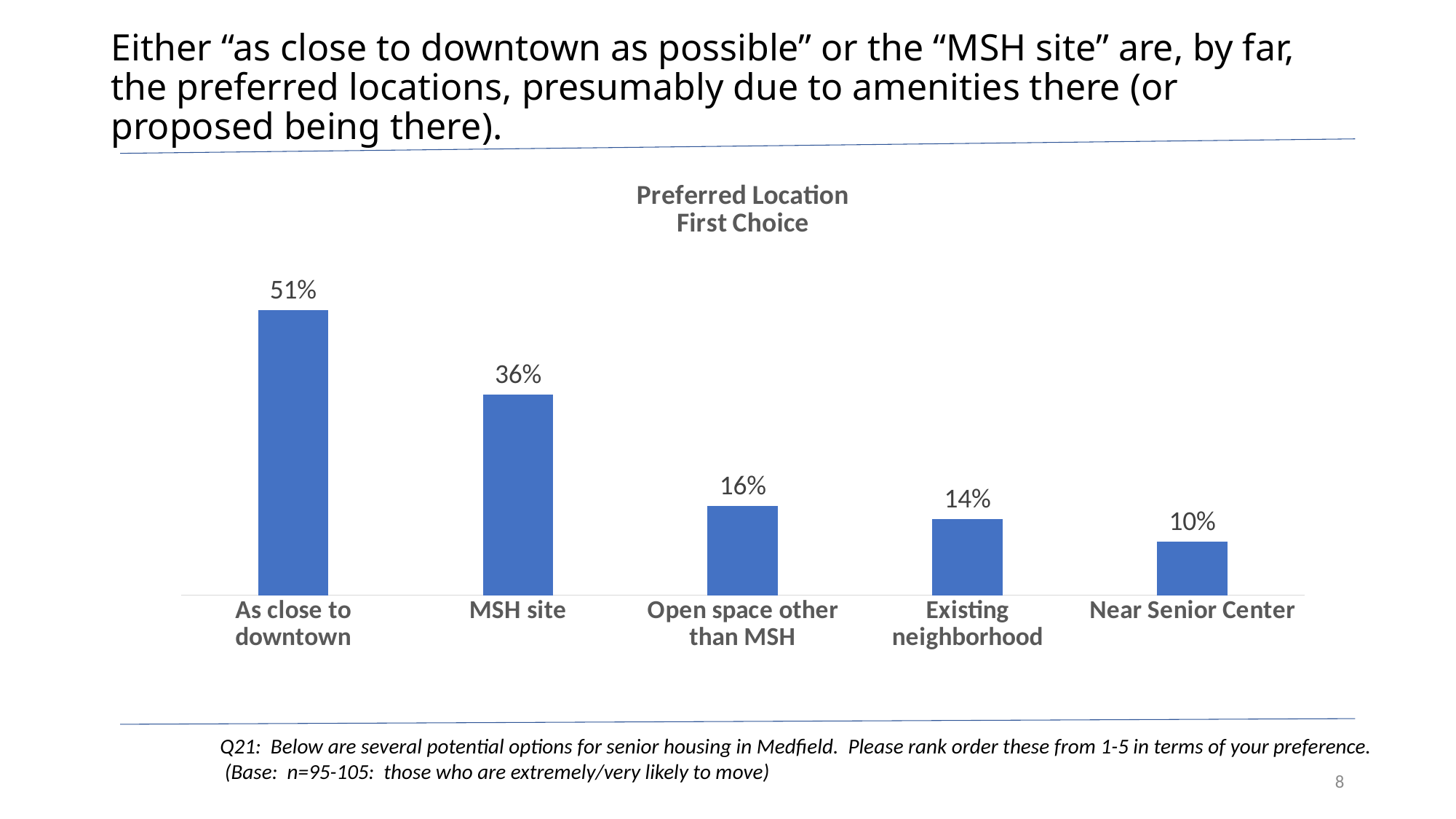
What percentage is shown for "Open space other than MSH"? 16% What is the title of the chart? Preferred Location First Choice What is the value shown for "MSH site"? 36% What is the value for "Near Senior Center"? 10% What percentage chose "As close to downtown" as their first choice preferred location? 51% Which location has the highest first-choice percentage? As close to downtown What is the difference in percentage points between "As close to downtown" and "MSH site"? 15 percentage points Which location has the lowest first-choice percentage? Near Senior Center What type of chart is shown on the slide? Bar chart How many location categories are shown in the chart? 5 What is the difference between "Existing neighborhood" and "Near Senior Center"? 4 percentage points Which is larger, the value for "Open space other than MSH" or for "Existing neighborhood"? Open space other than MSH